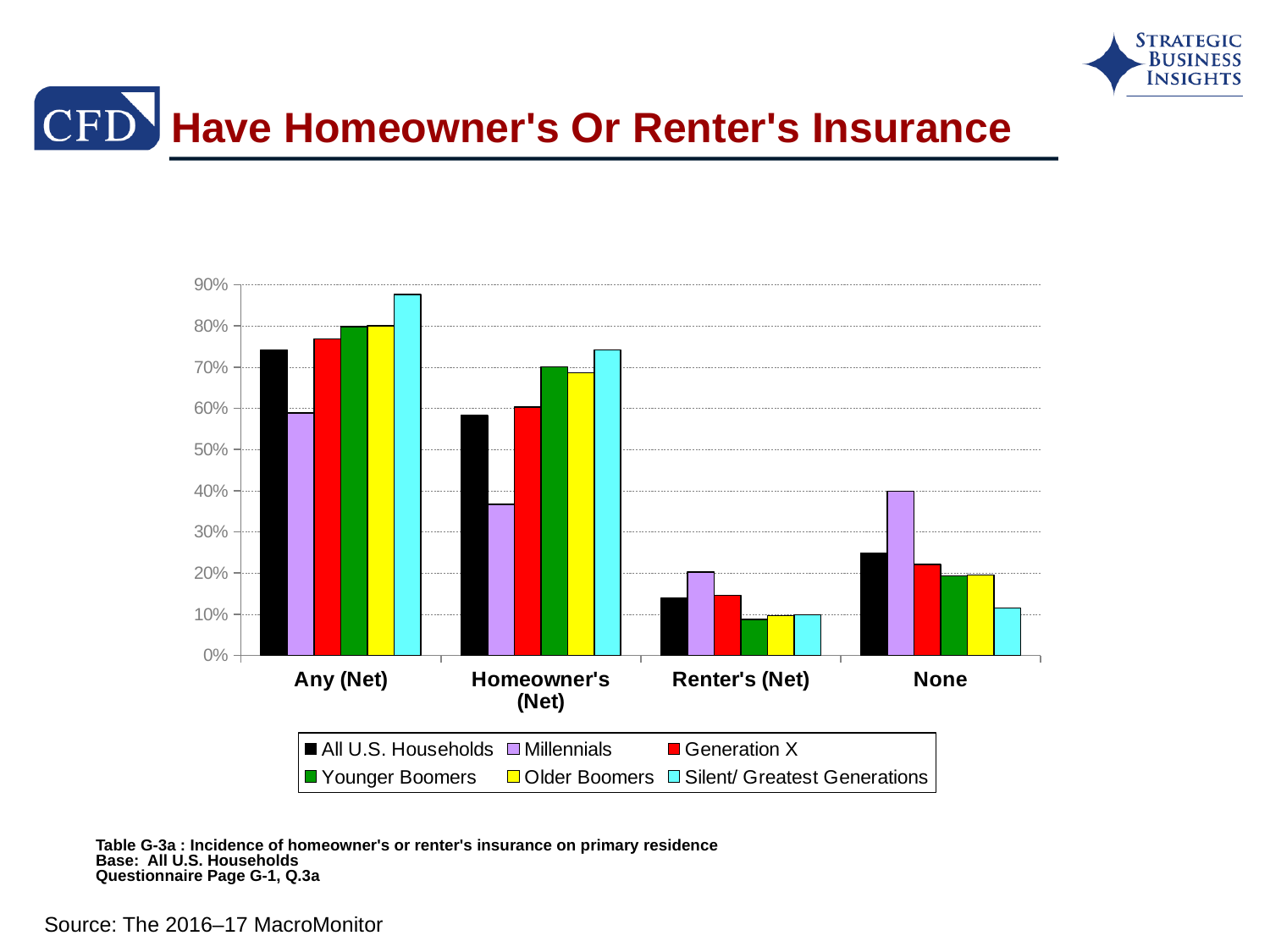
Is the value for Silent/ Greatest Generations in the Any (Net) category greater or less than 80%? greater In the Any (Net) category, which series has the highest value? Silent/ Greatest Generations In the Homeowner's (Net) category, which series has the lowest value? Millennials Is the value for All U.S. Households in the None category greater or less than 20%? greater How many series does the legend list? 6 In the Renter's (Net) category, which is larger: Millennials or Younger Boomers? Millennials What kind of chart is shown on the slide? bar chart In the None category, which series has the highest value? Millennials How many categories are shown along the x axis? 4 What colour represents Generation X in the legend? red In the None category, which series has the lowest value? Silent/ Greatest Generations Is the value for Millennials in the Homeowner's (Net) category greater or less than 40%? less